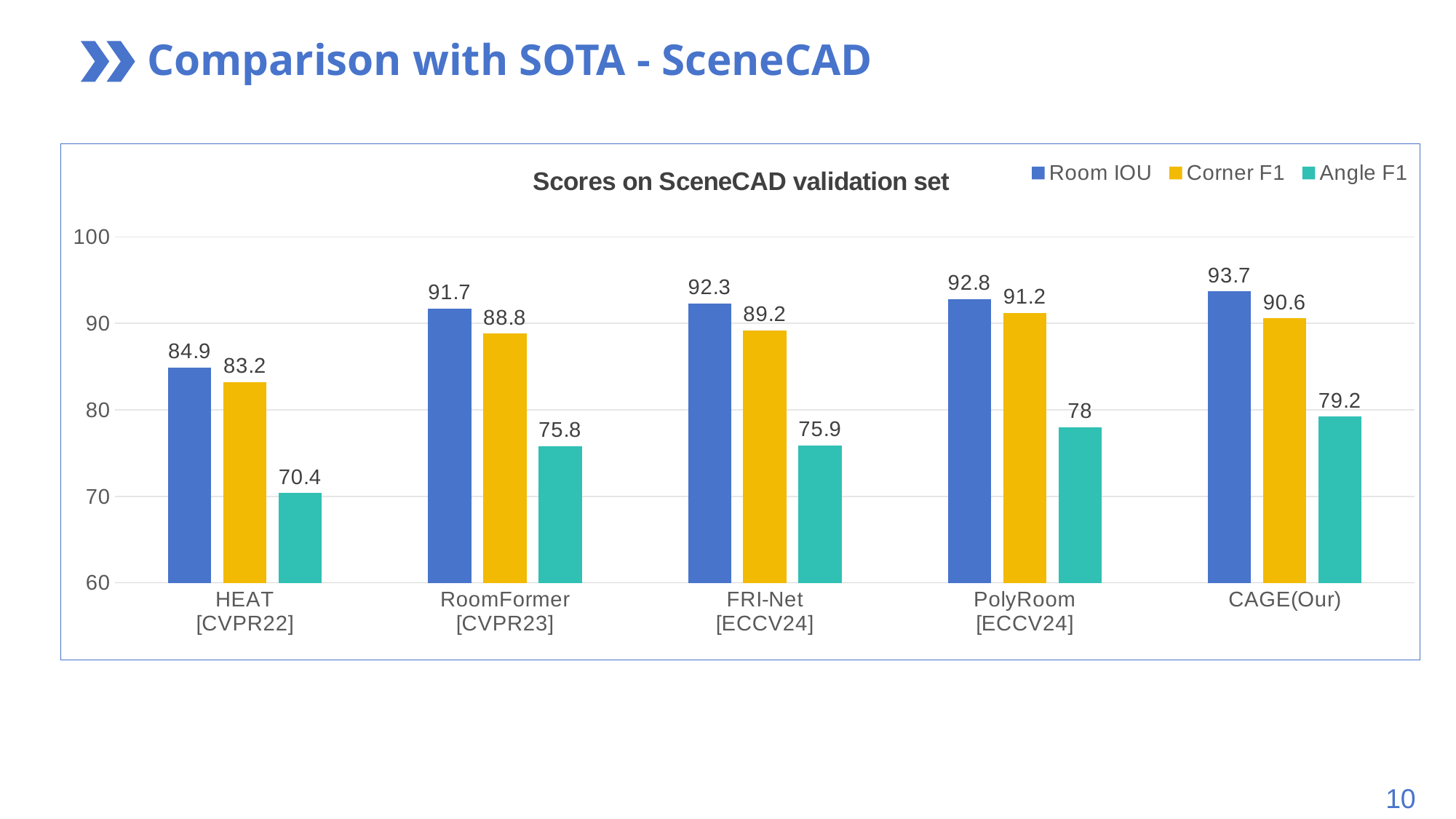
Which method has the lowest Corner F1? HEAT [CVPR22] What is the Room IOU value for CAGE(Our)? 93.7 Which method has the highest Room IOU? CAGE(Our) How many series does the legend list? 3 What is the difference between the Corner F1 of PolyRoom [ECCV24] and CAGE(Our)? 0.6 What kind of chart is shown? bar chart Is the Angle F1 value for RoomFormer [CVPR23] greater or less than 80? less What is the title of the chart? Scores on SceneCAD validation set How many methods are compared on the x axis? 5 Which is larger, the Angle F1 of PolyRoom [ECCV24] or the Angle F1 of CAGE(Our)? CAGE(Our) What is the Angle F1 value for HEAT [CVPR22]? 70.4 What is the Corner F1 value for FRI-Net [ECCV24]? 89.2